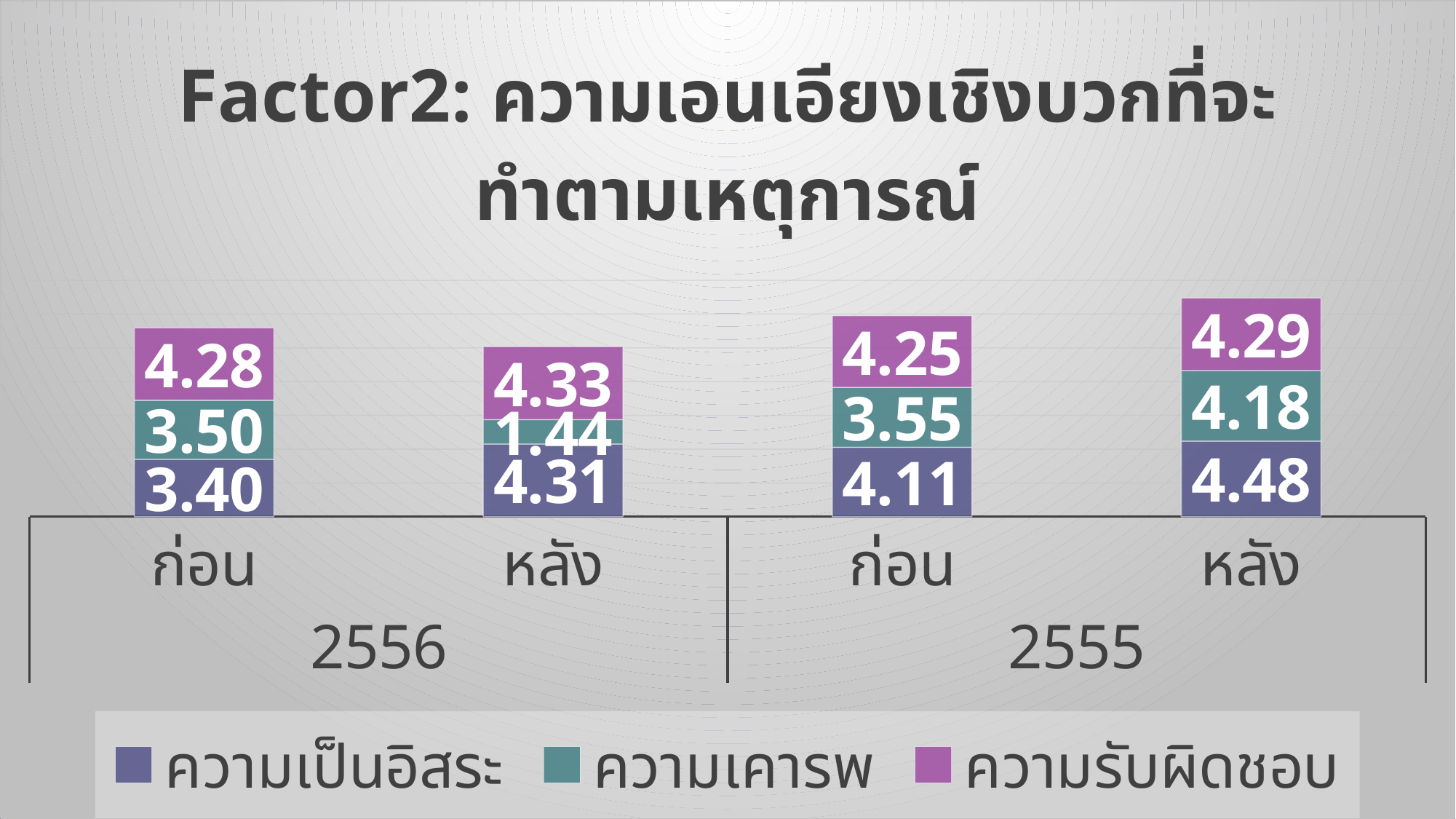
What is the value of ความเคารพ for หลัง in 2556? 1.44 How many series does the legend list? 3 What is the difference between the ความเป็นอิสระ values for หลัง 2555 and ก่อน 2555? 0.37 What is the value of ความรับผิดชอบ for ก่อน in 2555? 4.25 What is the value of ความเป็นอิสระ for ก่อน in 2556? 3.40 Which legend entry is shown in the magenta/purple colour at the top of each bar? ความรับผิดชอบ What is the value of ความเป็นอิสระ for หลัง in 2555? 4.48 How many bars (categories) are plotted in the chart? 4 What is the total of the stacked bar for หลัง in 2555? 12.95 Which category has the highest value for ความเป็นอิสระ? หลัง 2555 Which category has the lowest value for ความเคารพ? หลัง 2556 What type of chart is shown on the slide? stacked bar chart